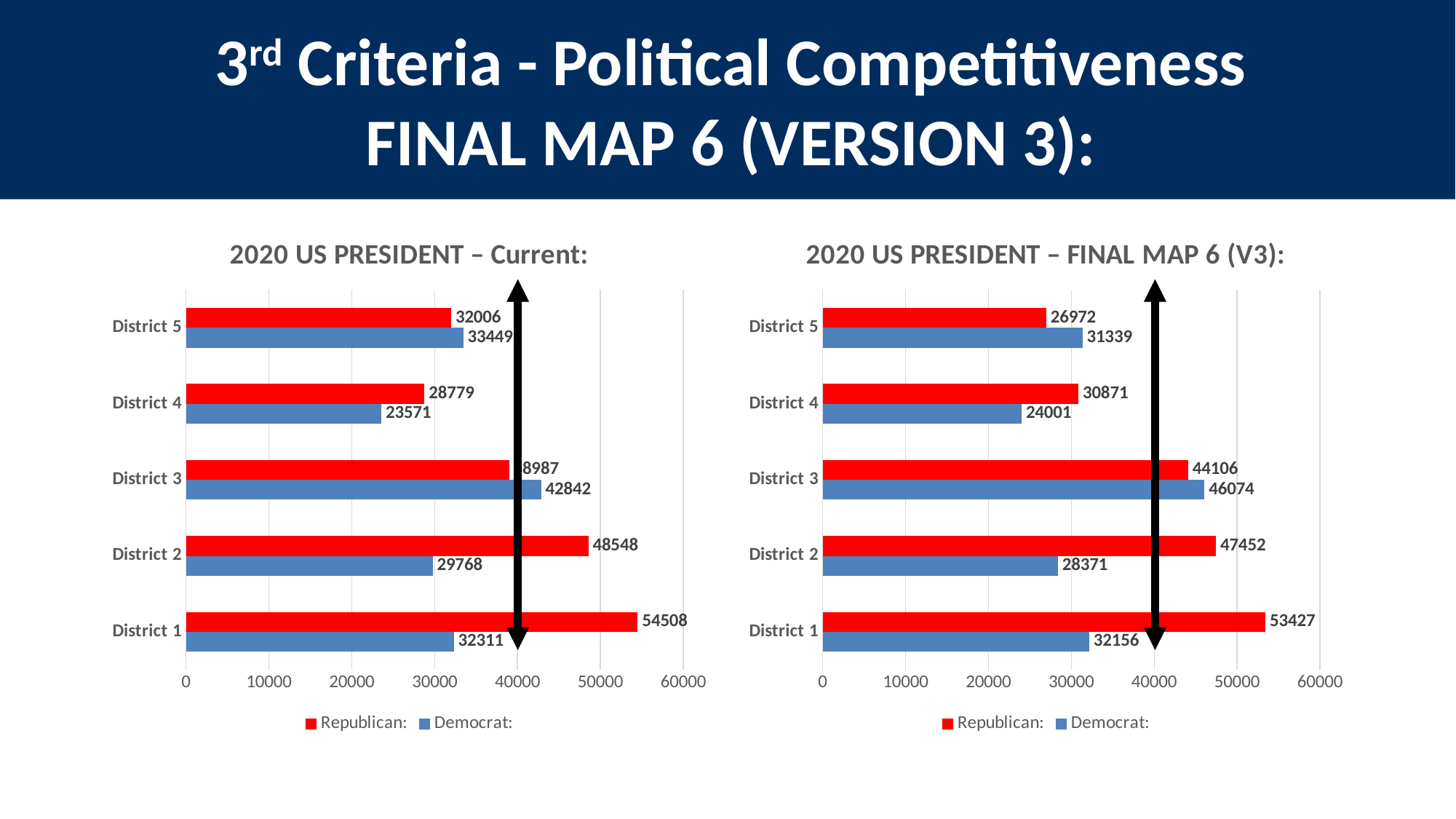
In the '2020 US PRESIDENT – Current:' chart, what is the Democrat value for District 4? 23571 In the '2020 US PRESIDENT – Current:' chart, which district has the lowest Democrat value? District 4 In the '2020 US PRESIDENT – FINAL MAP 6 (V3):' chart, what is the Republican value for District 5? 26972 In the '2020 US PRESIDENT – Current:' chart, which is larger for District 5, the Republican value or the Democrat value? Democrat In the '2020 US PRESIDENT – FINAL MAP 6 (V3):' chart, which district has the highest Republican value? District 1 In the '2020 US PRESIDENT – FINAL MAP 6 (V3):' chart, what is the Democrat value for District 3? 46074 In the '2020 US PRESIDENT – FINAL MAP 6 (V3):' chart, what is the difference between the Republican and Democrat values for District 2? 19081 How many series does the legend of the '2020 US PRESIDENT – FINAL MAP 6 (V3):' chart list? 2 In the '2020 US PRESIDENT – Current:' chart, what is the Republican value for District 1? 54508 What kind of chart is the '2020 US PRESIDENT – Current:' chart? Bar chart How many districts are shown in the '2020 US PRESIDENT – Current:' chart? 5 In the '2020 US PRESIDENT – FINAL MAP 6 (V3):' chart, is the Republican value for District 1 greater or less than 50000? greater